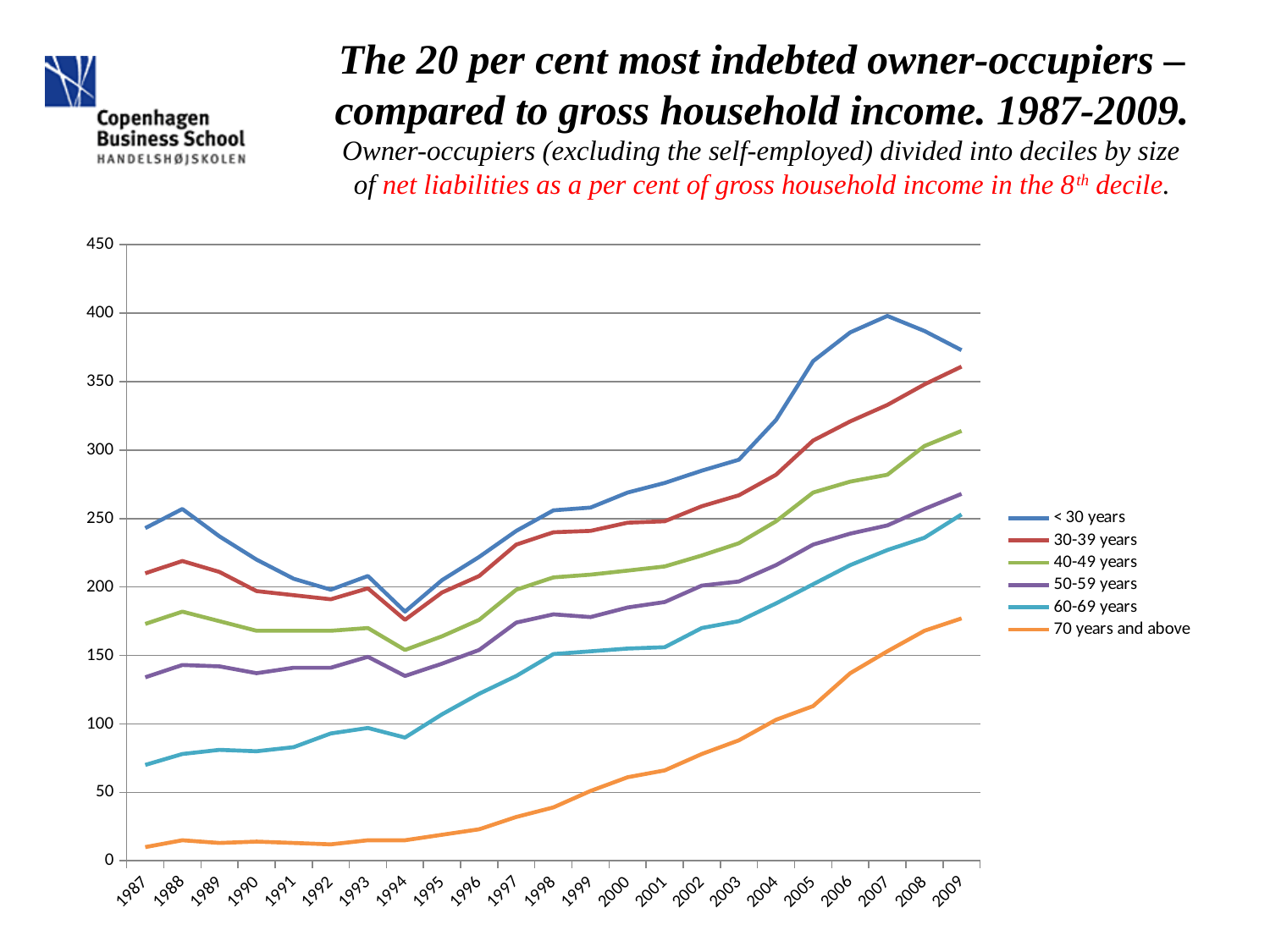
In which year does the '< 30 years' series reach its lowest value? 1994 Is the value for '70 years and above' in 1987 greater or less than 50? less What kind of chart is shown on the slide? Line chart In which year does the '< 30 years' series reach its peak? 2007 Which is larger in 2000, the value for '30-39 years' or for '40-49 years'? 30-39 years How many years are plotted along the x axis? 23 Which age group has the highest value in 2009? < 30 years How many series does the legend list? 6 Which age group has the lowest value in 2009? 70 years and above Is the value for '60-69 years' in 2009 greater or less than 200? greater Does the '70 years and above' series rise or fall from 1987 to 2009? rise Is the value for '< 30 years' in 2007 greater or less than 350? greater